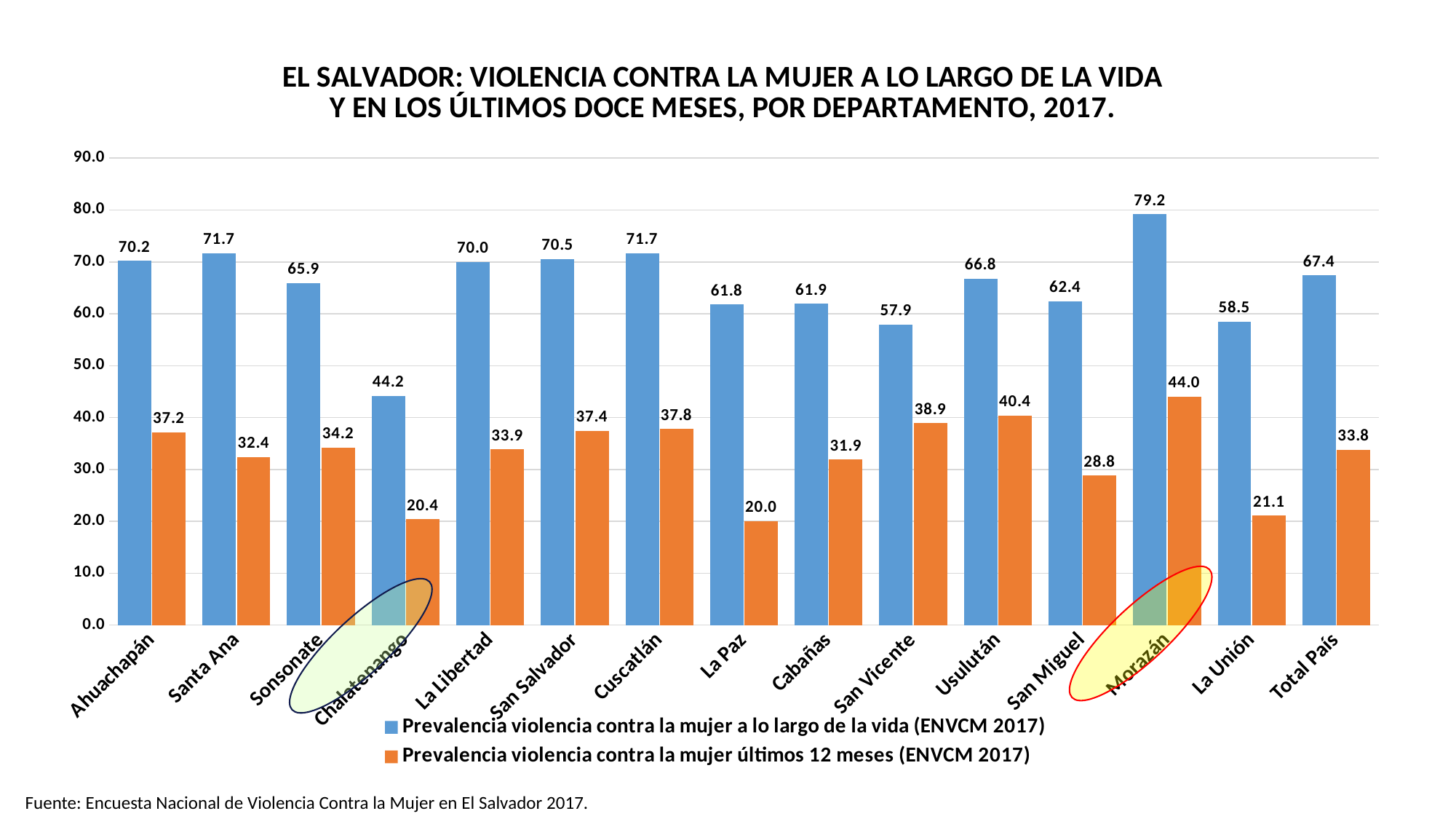
Which department has the lowest prevalence of violence in the last 12 months? La Paz What is the difference between the lifetime prevalence and the last-12-months prevalence for Morazán? 35.2 Which department has the highest lifetime prevalence of violence against women? Morazán How many series does the legend list? 2 What is the lifetime prevalence value (blue bar) for Morazán? 79.2 What is the last-12-months prevalence value (orange bar) for La Paz? 20.0 What kind of chart is shown on the slide? Bar chart What is the lifetime prevalence value for Total País? 67.4 Which is larger: the last-12-months prevalence for Usulután or for San Vicente? Usulután Is the lifetime prevalence value for La Unión greater or less than 60.0? less How many categories are shown on the x axis? 15 Which department has the lowest lifetime prevalence of violence against women? Chalatenango